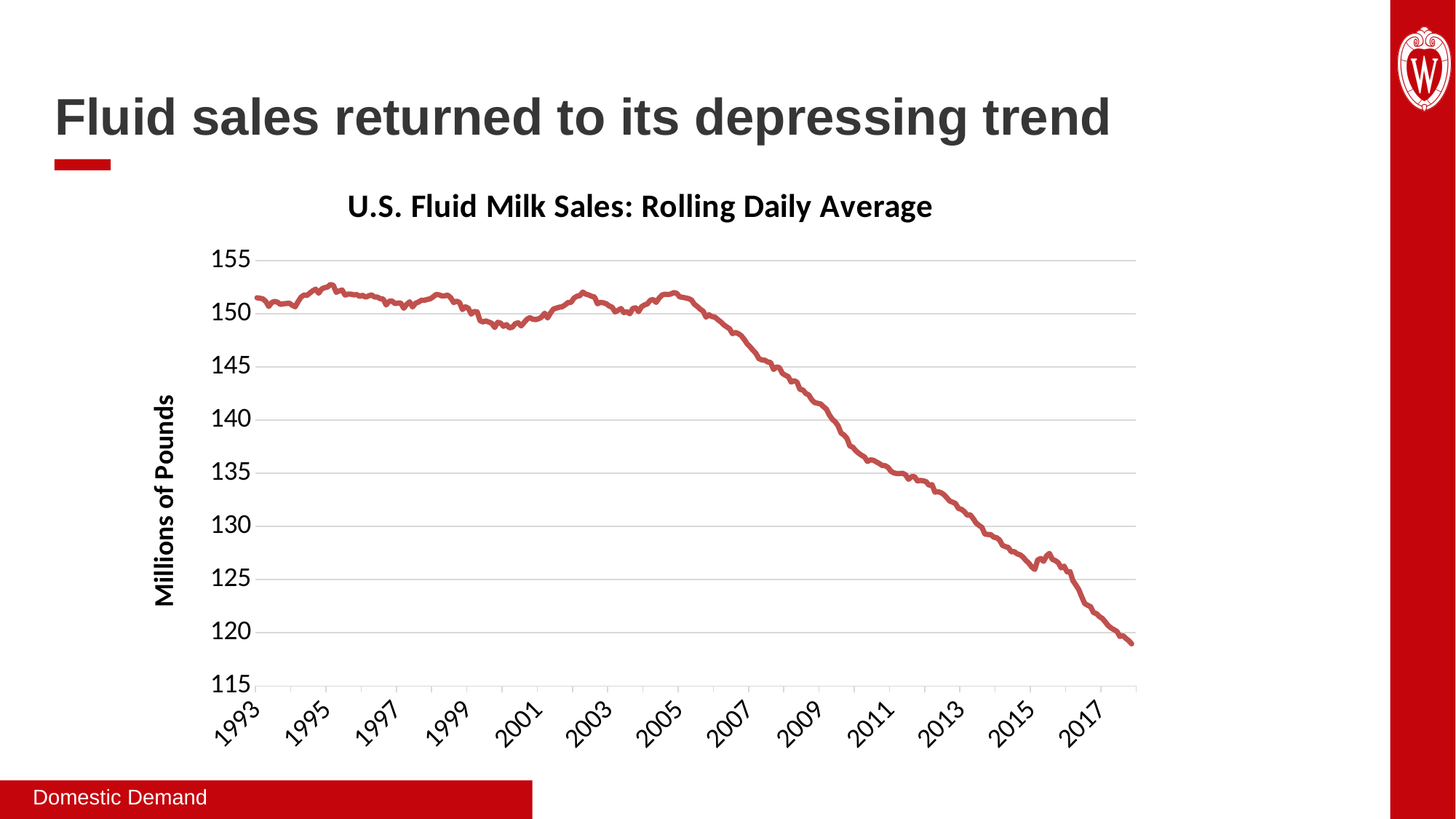
Is the value for 1993 greater or less than 150? greater Do the values rise or fall between 2005 and 2017? fall Is the value for 2013 greater or less than 135? less Overall, do the values rise or fall from 1993 to 2017? fall How many year labels are shown on the horizontal axis? 13 Is the value for 2015 greater or less than 130? less What is the title of the chart? U.S. Fluid Milk Sales: Rolling Daily Average Which is larger, the value for 1993 or the value for 2017? 1993 What kind of chart is shown on the slide? line chart What is the label on the vertical axis of the chart? Millions of Pounds